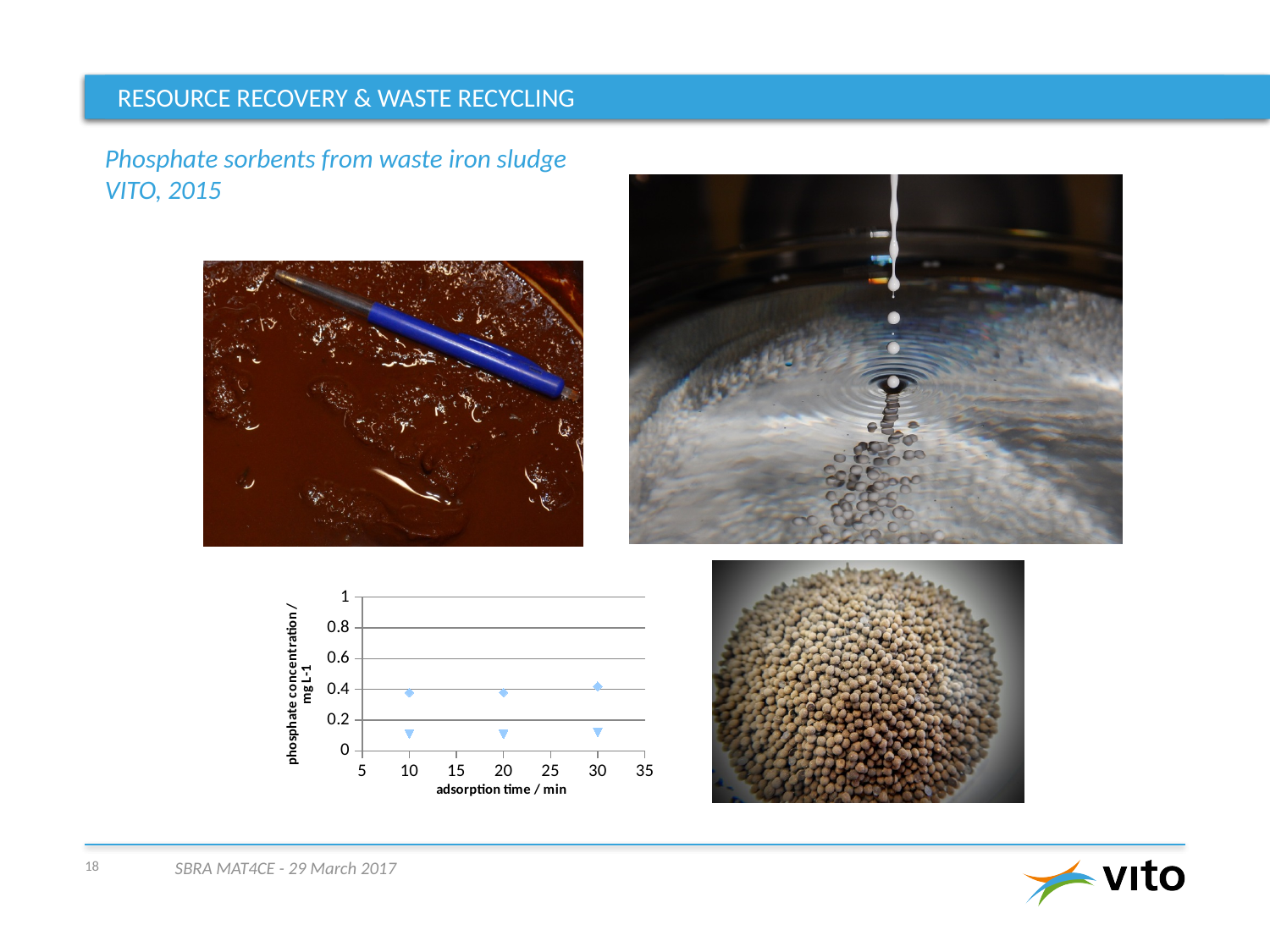
What kind of chart is shown on the slide? scatter chart Is the triangle-marker value at 30 min adsorption time greater or less than 0.4 mg L-1? less Is the triangle-marker value at 20 min adsorption time greater or less than 0.2 mg L-1? less Is the diamond-marker value at 10 min adsorption time greater or less than 0.6 mg L-1? less What is the label of the x axis of the chart? adsorption time / min At 30 min adsorption time, which series has the lower phosphate concentration, the diamond markers or the triangle markers? triangle markers What is the label of the y axis of the chart? phosphate concentration / mg L-1 What is the highest value shown on the y axis of the chart? 1 At 10 min adsorption time, which series has the higher phosphate concentration, the diamond markers or the triangle markers? diamond markers How many adsorption time points are plotted for each series in the chart? 3 How many different marker series are plotted in the chart? 2